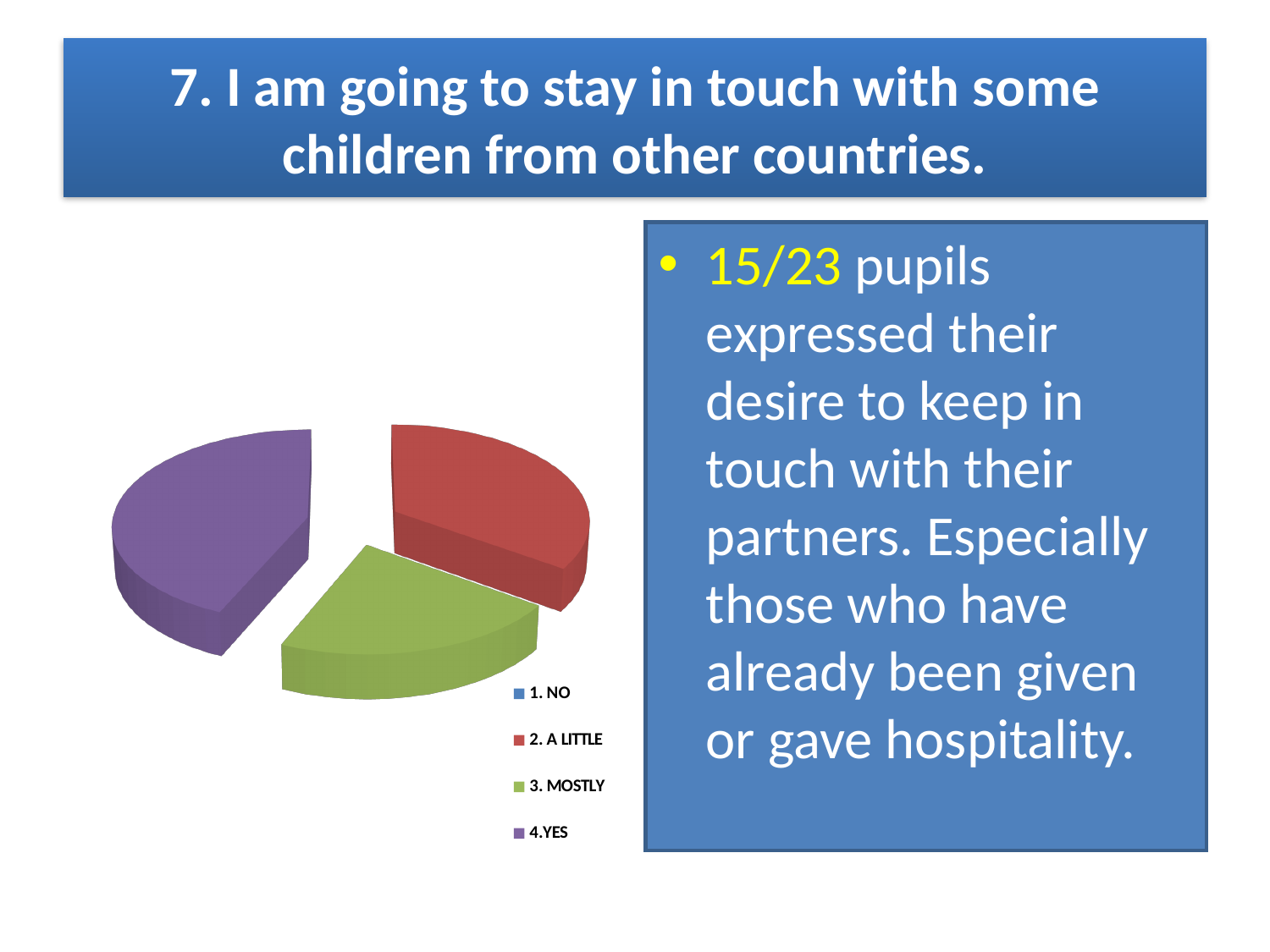
Which legend category is shown in green in the pie chart? 3. MOSTLY What colour is the 4.YES slice in the pie chart? purple Which slice is larger in the pie chart, 4.YES or 2. A LITTLE? 4.YES Which legend category has no visible slice in the pie chart? 1. NO What kind of chart is shown on the slide? pie chart Which category has the largest slice in the pie chart? 4.YES Which slice is larger in the pie chart, 4.YES or 3. MOSTLY? 4.YES How many categories does the legend of the pie chart list? 4